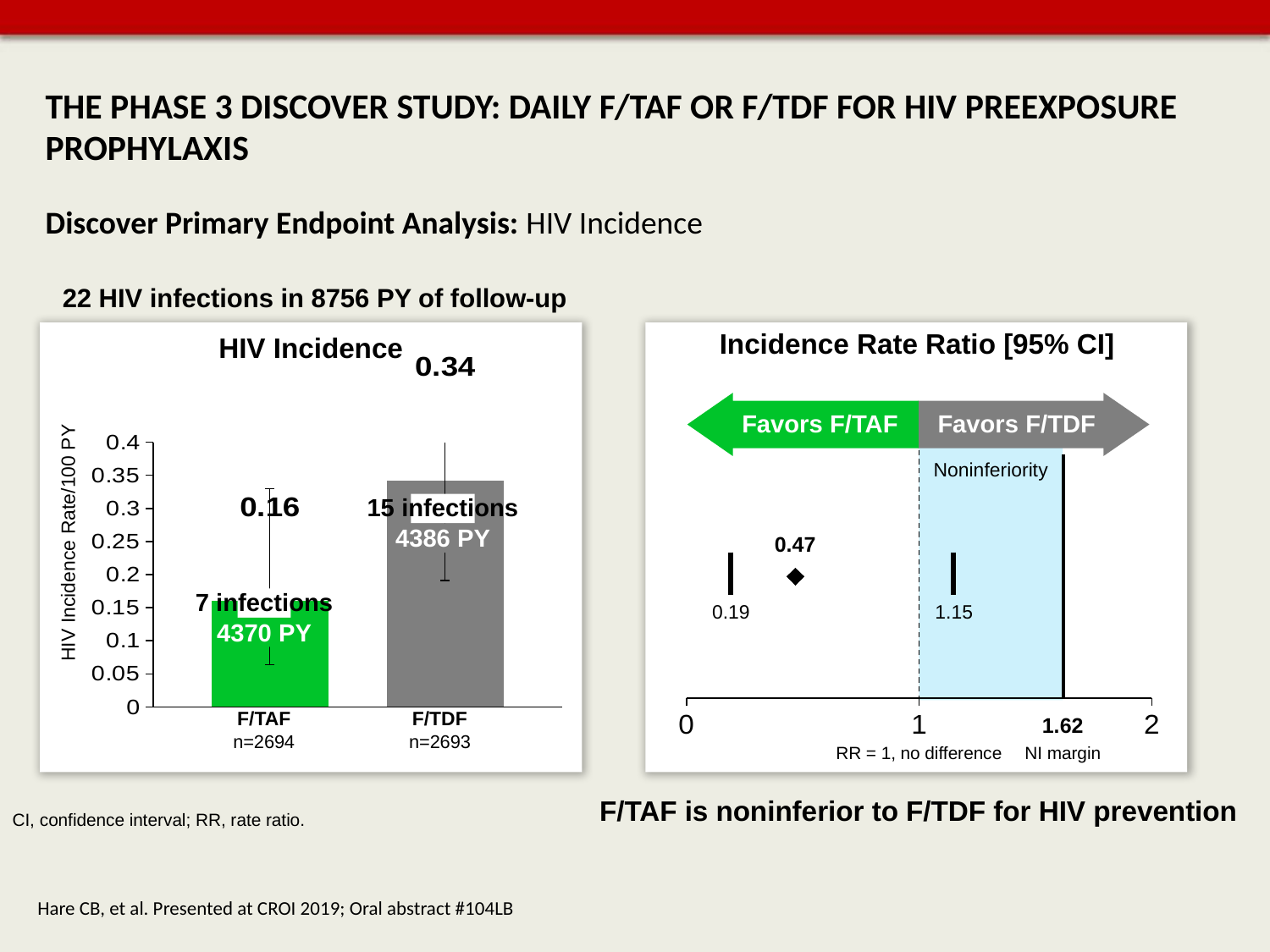
In the HIV Incidence chart, which group has the higher HIV incidence rate? F/TDF In the HIV Incidence chart, what is the HIV incidence rate per 100 PY for F/TDF? 0.34 What kind of chart is the HIV Incidence chart? Bar chart In the HIV Incidence chart, which group has the lower HIV incidence rate? F/TAF In the Incidence Rate Ratio [95% CI] chart, what value is the NI margin set at? 1.62 In the HIV Incidence chart, how many groups (bars) are plotted? 2 In the HIV Incidence chart, what is the difference between the F/TDF and F/TAF incidence rates? 0.18 In the Incidence Rate Ratio [95% CI] chart, what are the lower and upper bounds of the 95% CI? 0.19 and 1.15 In the HIV Incidence chart, what is the HIV incidence rate per 100 PY for F/TAF? 0.16 In the HIV Incidence chart, how many person-years of follow-up are shown for the F/TDF group? 4386 PY In the Incidence Rate Ratio [95% CI] chart, what is the point estimate of the incidence rate ratio? 0.47 In the HIV Incidence chart, how many infections occurred in the F/TAF group? 7 infections